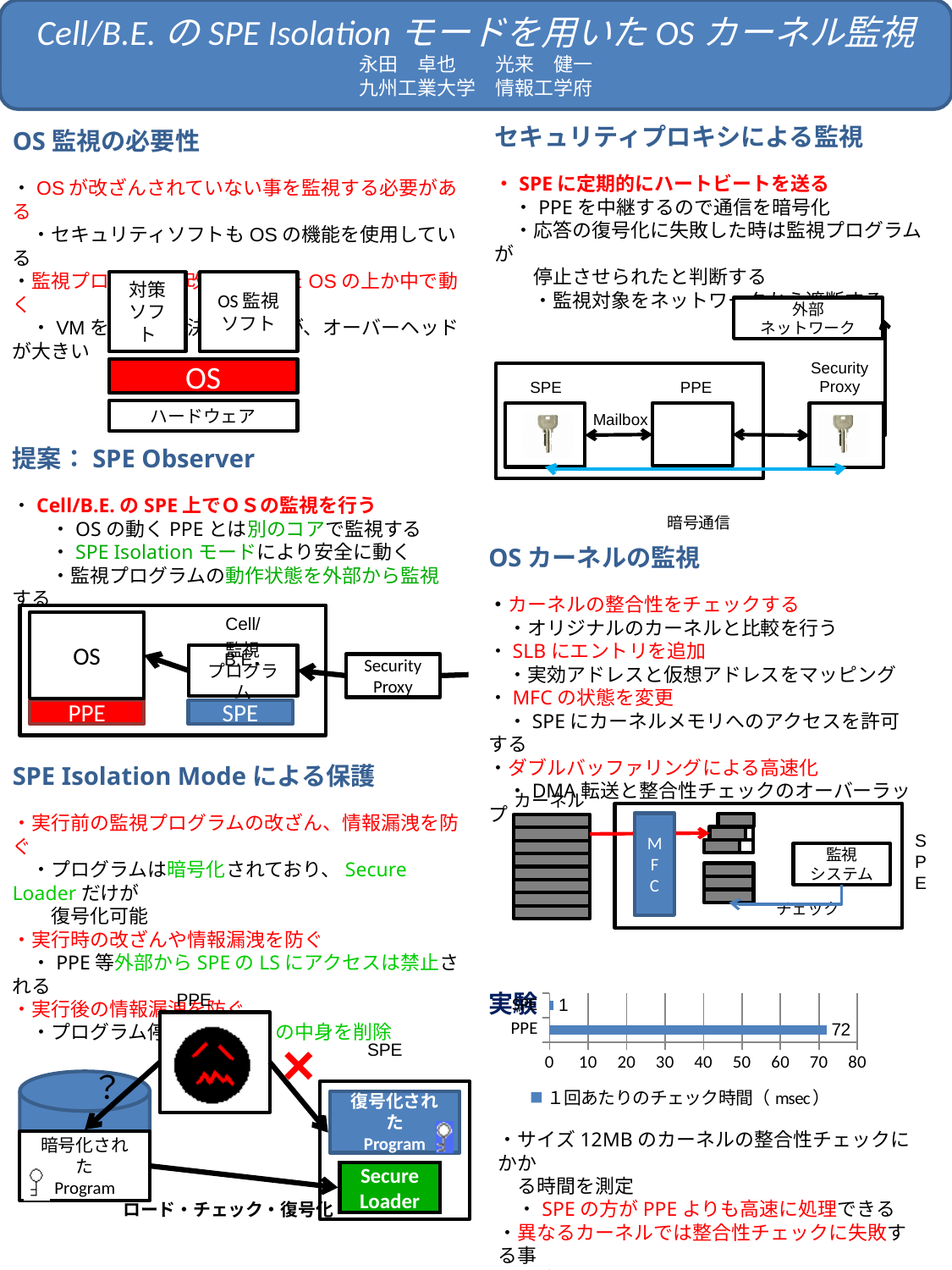
What kind of chart is shown under 実験? bar chart How many series does the legend of the chart under 実験 list? 1 In the chart under 実験, which category has the highest value? PPE How many bars are plotted in the chart under 実験? 2 In the chart under 実験, is the value for PPE greater or less than 70? greater In the chart under 実験, what is the difference between the PPE bar and the top bar? 71 In the chart under 実験, what is the value shown on the top bar? 1 In the chart under 実験, which is larger, the PPE bar or the top bar? PPE What does the legend of the chart under 実験 say? 1回あたりのチェック時間（ msec） What is the value for PPE in the bar chart under 実験? 72 What is the maximum value shown on the x axis of the chart under 実験? 80